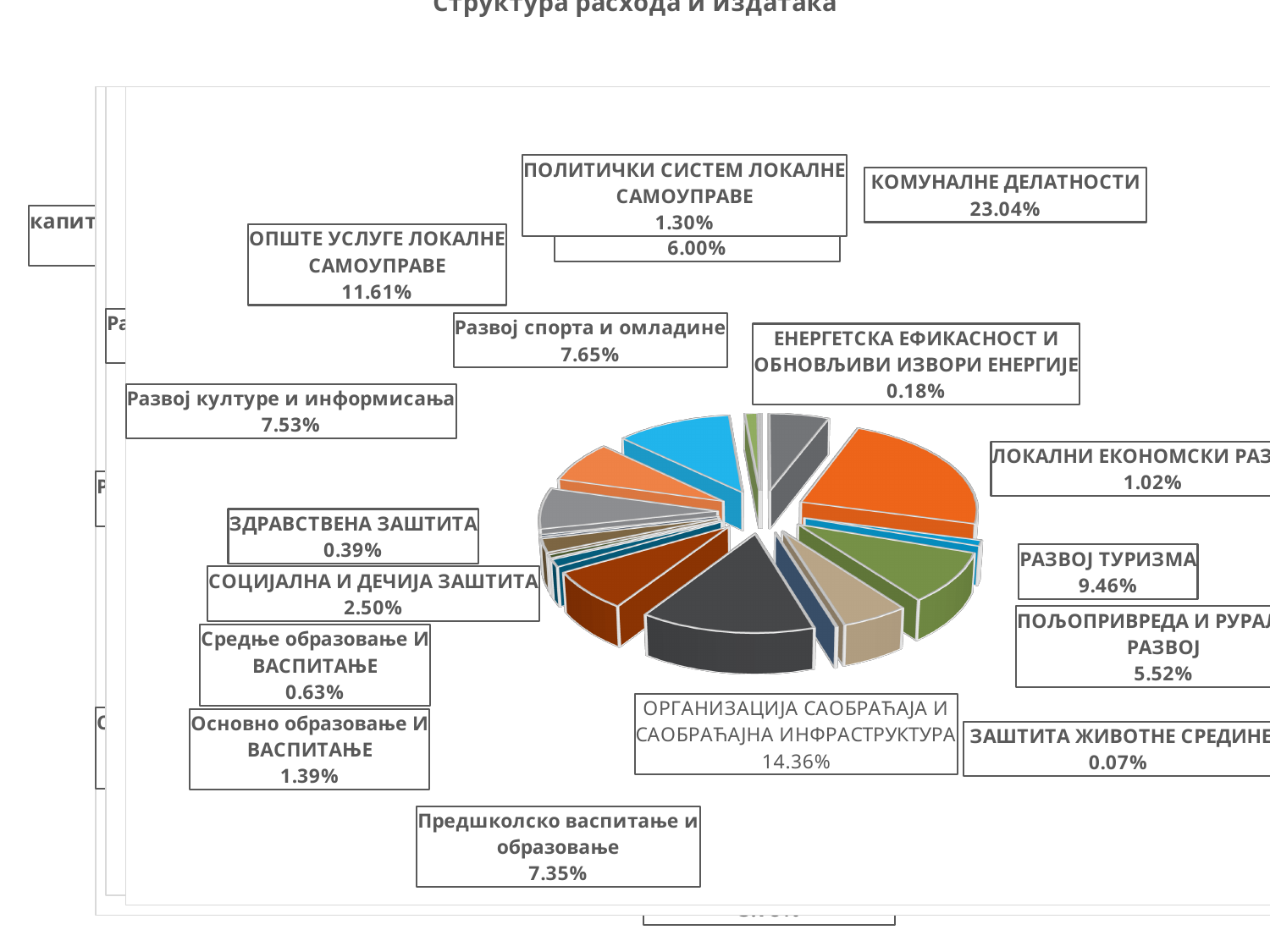
Which is larger, РАЗВОЈ ТУРИЗМА or Развој спорта и омладине? РАЗВОЈ ТУРИЗМА What is the value shown for Предшколско васпитање и образовање? 7.35% What is the difference in percentage points between КОМУНАЛНЕ ДЕЛАТНОСТИ and ОРГАНИЗАЦИЈА САОБРАЋАЈА И САОБРАЋАЈНА ИНФРАСТРУКТУРА? 8.68 Which category has the smallest share of the pie? ЗАШТИТА ЖИВОТНЕ СРЕДИНЕ What is the value shown for ЗДРАВСТВЕНА ЗАШТИТА? 0.39% What kind of chart is shown on the slide? pie chart What is the value shown for ОПШТЕ УСЛУГЕ ЛОКАЛНЕ САМОУПРАВЕ? 11.61% What is the value shown for РАЗВОЈ ТУРИЗМА? 9.46% What is the difference in percentage points between ОПШТЕ УСЛУГЕ ЛОКАЛНЕ САМОУПРАВЕ and Развој културе и информисања? 4.08 What is the value shown for ОРГАНИЗАЦИЈА САОБРАЋАЈА И САОБРАЋАЈНА ИНФРАСТРУКТУРА? 14.36% What share of the pie does КОМУНАЛНЕ ДЕЛАТНОСТИ have? 23.04% Which category has the largest share of the pie? КОМУНАЛНЕ ДЕЛАТНОСТИ